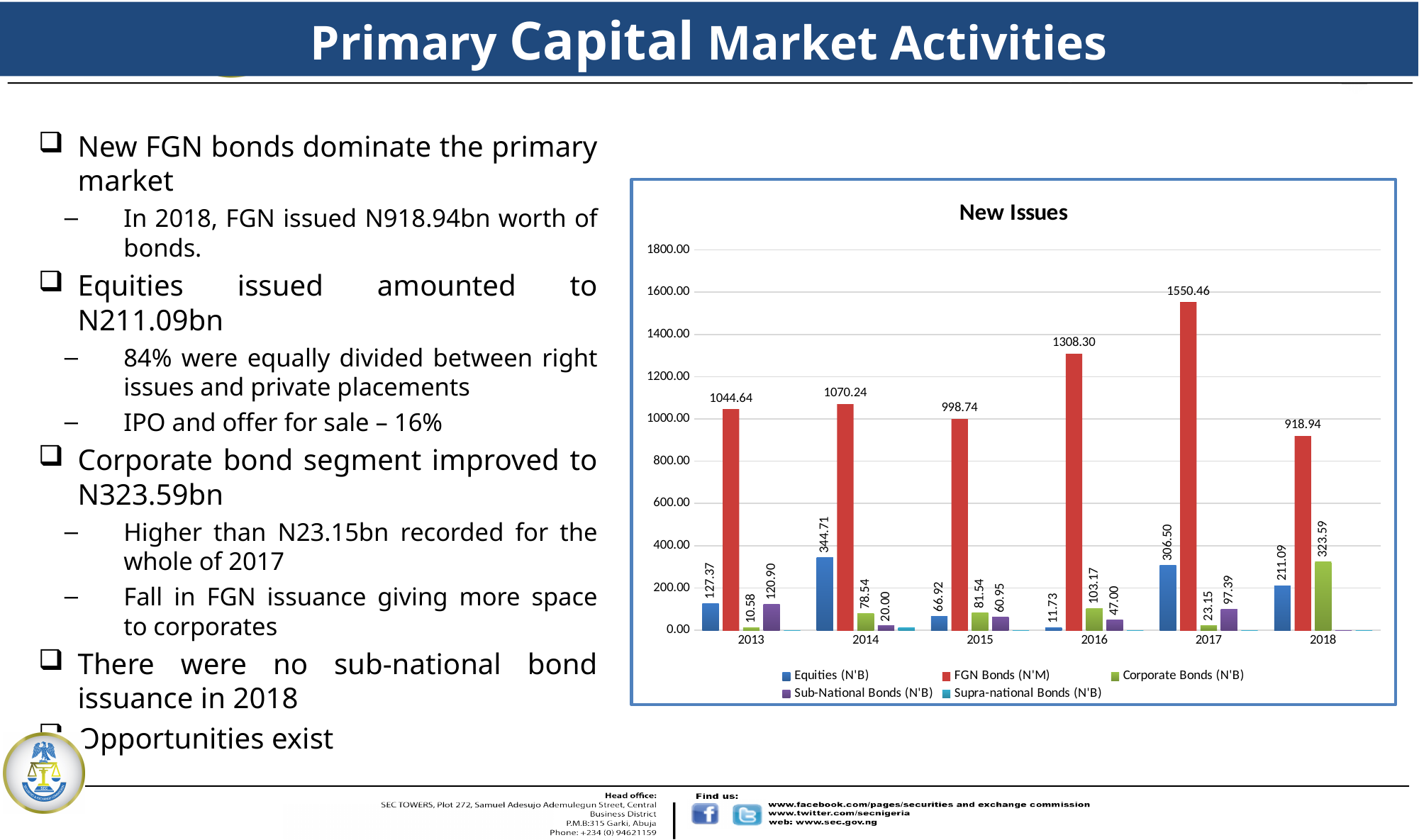
In the New Issues chart, what is the value for FGN Bonds in 2017? 1550.46 How many years are shown on the x axis of the New Issues chart? 6 In the New Issues chart, what is the difference between the Corporate Bonds values for 2018 and 2017? 300.44 In the New Issues chart, which year has the lowest FGN Bonds value? 2018 In the New Issues chart, do the Corporate Bonds values rise or fall from 2013 to 2016? rise In the New Issues chart, what is the value for Equities in 2014? 344.71 How many series does the legend of the New Issues chart list? 5 In the New Issues chart, what is the value for Sub-National Bonds in 2013? 120.90 In the New Issues chart, which year has the larger Equities value, 2014 or 2017? 2014 In the New Issues chart, which year has the highest FGN Bonds value? 2017 What kind of chart is the New Issues chart? bar chart In the New Issues chart, what is the value for Corporate Bonds in 2018? 323.59